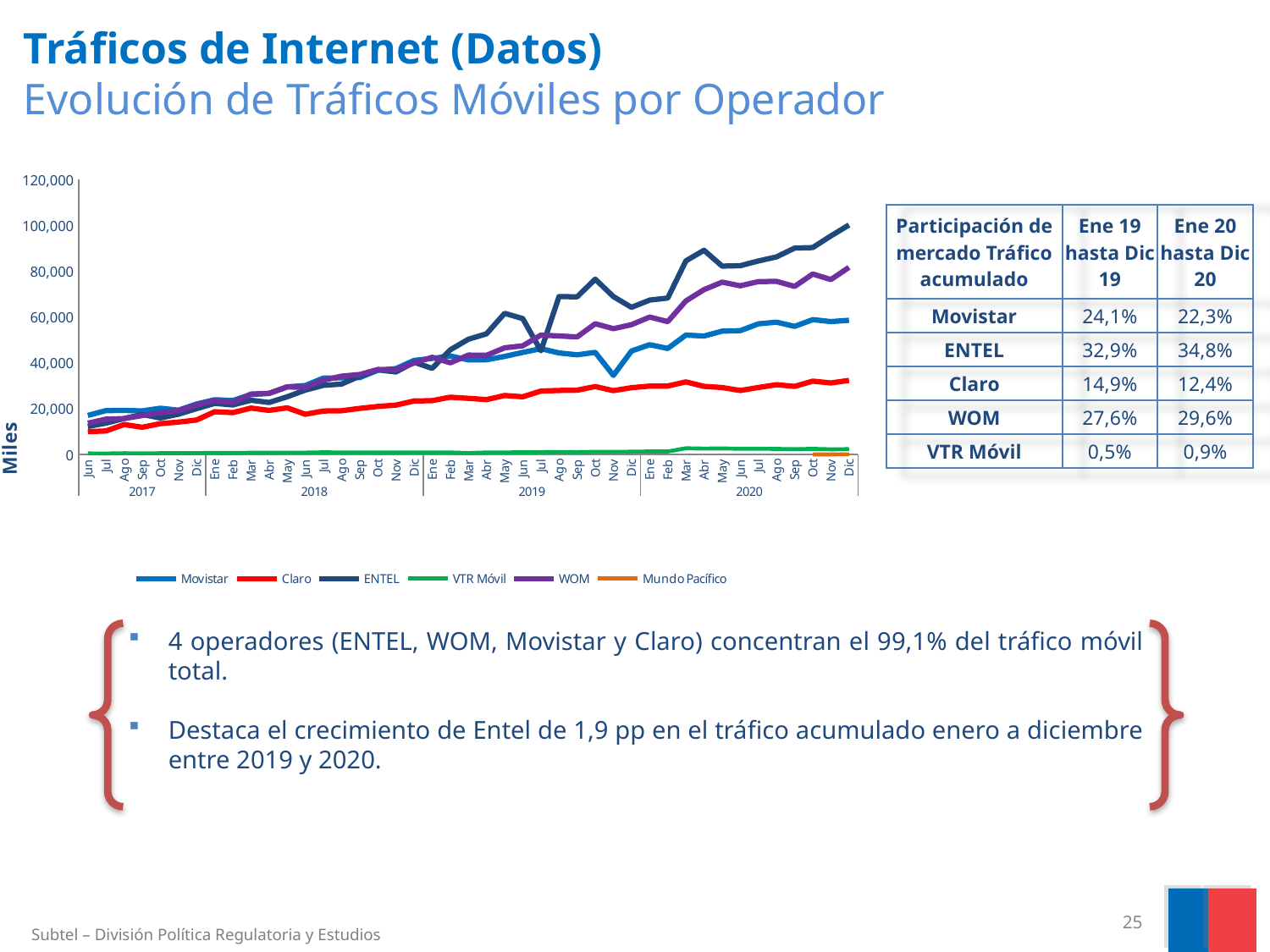
Is the value for WOM at Dic 2020 greater or less than 60,000? greater Is the value for Claro at Dic 2020 greater or less than 40,000? less How many series does the chart legend list? 6 Which operator has the highest traffic at Dic 2020 in the chart? ENTEL How many years are labelled along the x axis of the chart? 4 What kind of chart is shown on the slide? Line chart What colour is the Claro line in the chart? Red Is the value for ENTEL at Dic 2020 greater or less than 80,000? greater Does the ENTEL line rise or fall overall from Jun 2017 to Dic 2020? rise What is the label on the vertical axis of the chart? Miles At Dic 2020, which is larger, the value for Claro or the value for Movistar? Movistar